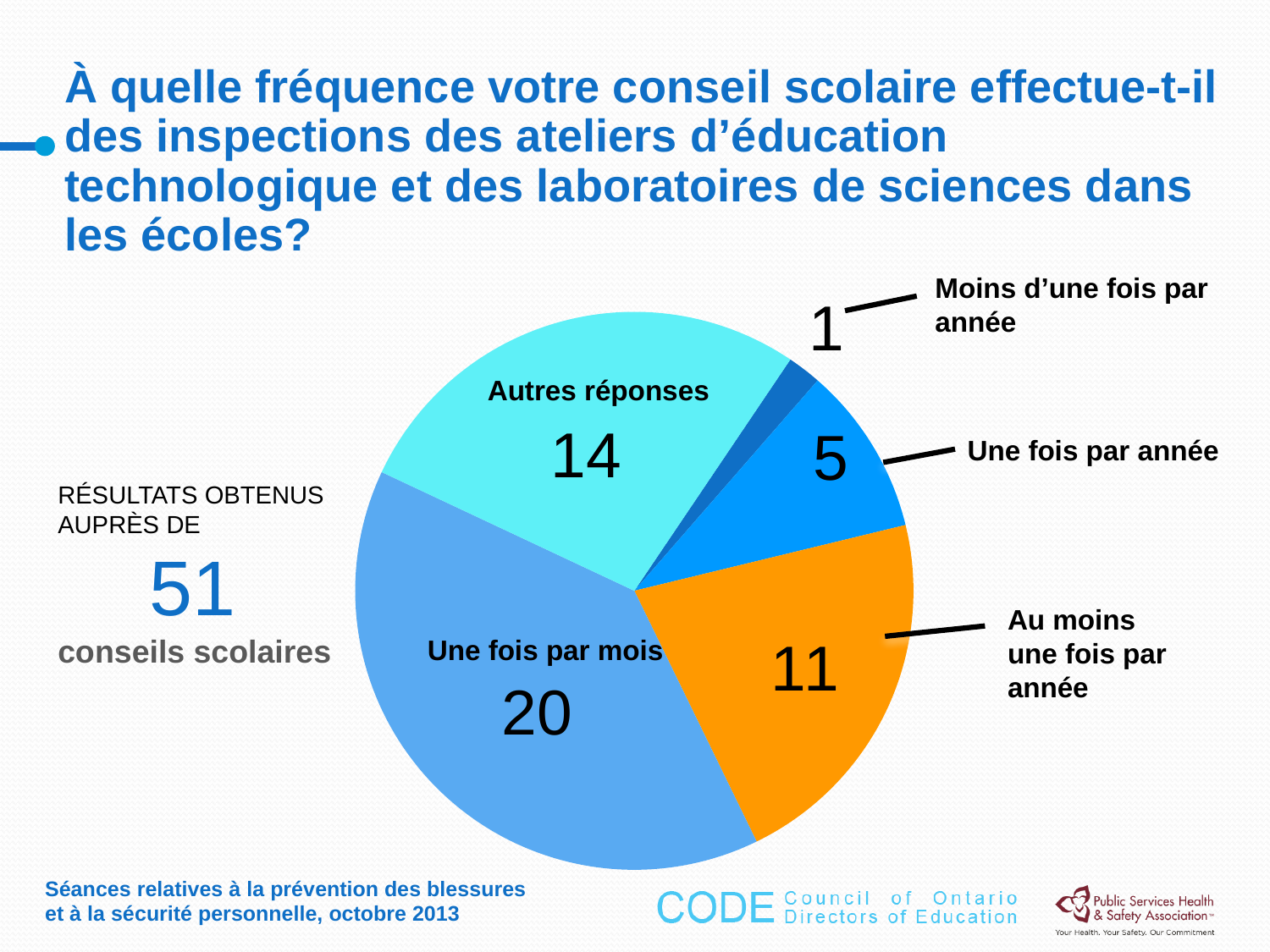
What is the value for "Autres réponses"? 14 What is the value for "Au moins une fois par année"? 11 What is the value for "Une fois par mois"? 20 Which category has the largest slice of the pie? Une fois par mois How many slices does the pie chart have? 5 Which is larger, the value for "Au moins une fois par année" or the value for "Une fois par année"? Au moins une fois par année What is the difference between the values for "Une fois par mois" and "Autres réponses"? 6 What is the value for "Moins d'une fois par année"? 1 Which category has the smallest slice of the pie? Moins d'une fois par année What is the value for "Une fois par année"? 5 What is the total of all the slices in the pie chart? 51 What kind of chart is shown on the slide? pie chart